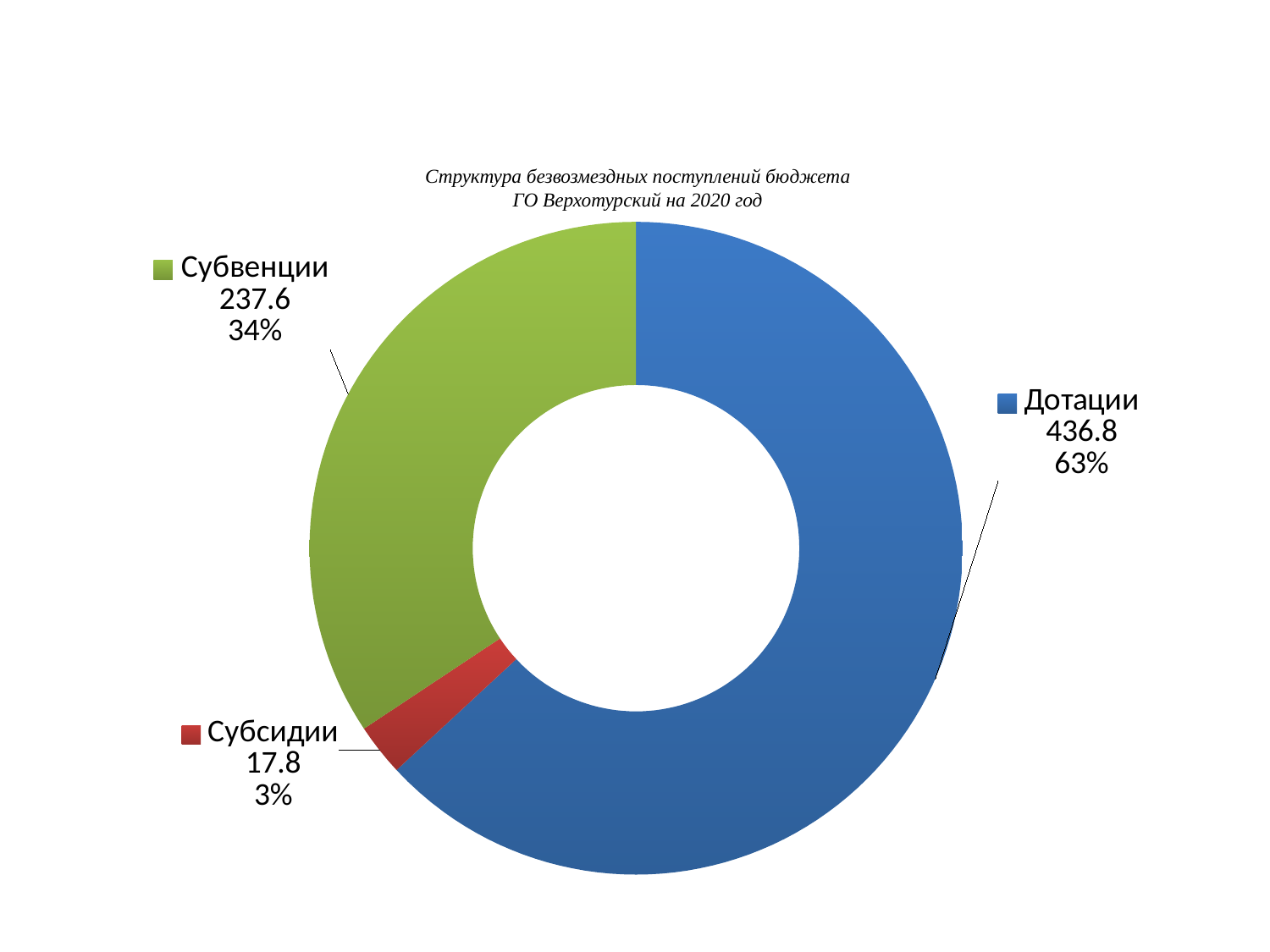
What is the value for Дотации? 436.8 Which is larger, the value for Субвенции or the value for Субсидии? Субвенции What is the difference between the values for Дотации and Субвенции? 199.2 What is the value for Субвенции? 237.6 Which category has the smallest share of the chart? Субсидии What percentage share does Субвенции have? 34% Which category has the largest share of the chart? Дотации How many categories are shown in the chart? 3 What kind of chart is shown on the slide? Doughnut (pie) chart What colour is the Субсидии segment? Red What is the value for Субсидии? 17.8 What percentage share does Дотации have? 63%